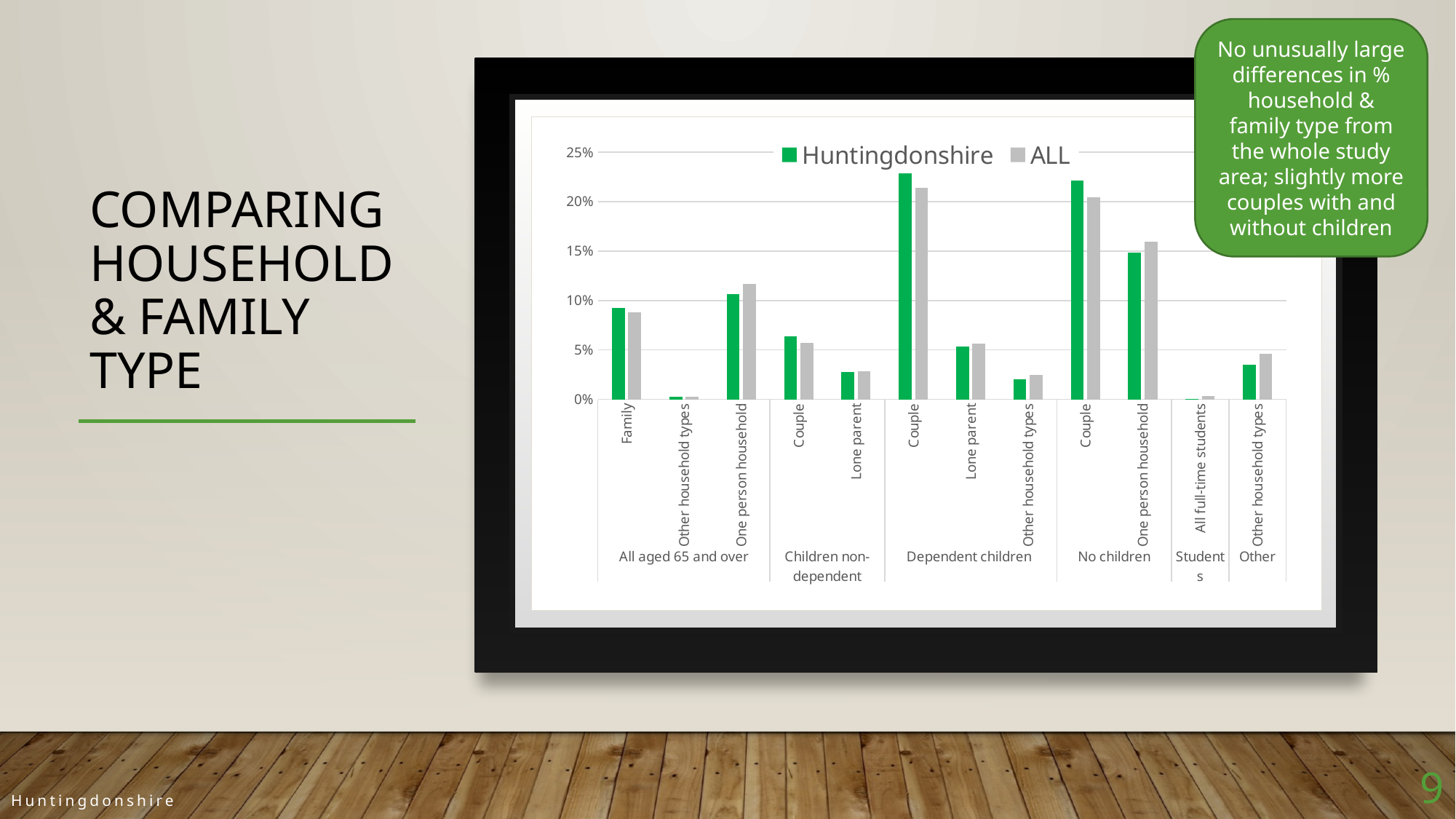
Which series is shown in green in the chart? Huntingdonshire Is the ALL value for Lone parent under Children non-dependent greater or less than 5%? less Is the ALL value for One person household under No children greater or less than 15%? greater How many series does the chart legend list? 2 What kind of chart is shown on the slide? bar chart For One person household under All aged 65 and over, which series has the larger value, Huntingdonshire or ALL? ALL For Couple under No children, which series has the larger value, Huntingdonshire or ALL? Huntingdonshire Is the Huntingdonshire value for Family under All aged 65 and over greater or less than 10%? less For Other household types under Other, which series has the larger value, Huntingdonshire or ALL? ALL How many household-type categories are plotted along the x axis of the chart? 12